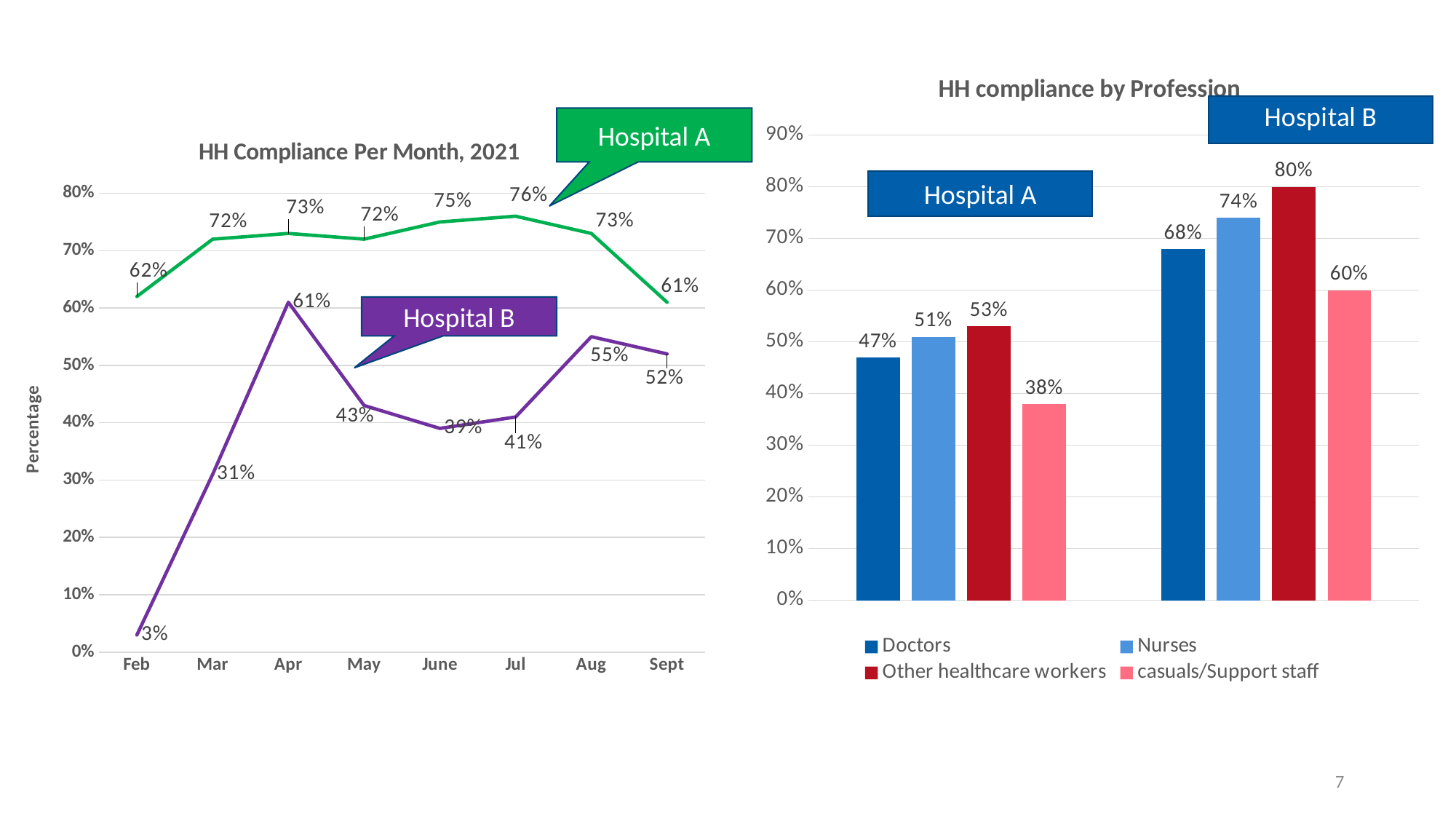
In the 'HH compliance by Profession' chart, how many series does the legend list? 4 In the 'HH Compliance Per Month, 2021' chart, what was Hospital B's compliance in Feb? 3% In the 'HH Compliance Per Month, 2021' chart, what was Hospital A's compliance in Jul? 76% In the 'HH Compliance Per Month, 2021' chart, what is the difference between Hospital A and Hospital B in Sept? 9% In the 'HH Compliance Per Month, 2021' chart, in which month was Hospital A's compliance lowest? Sept What kind of chart is 'HH Compliance Per Month, 2021'? Line chart In the 'HH compliance by Profession' chart, which profession has the lowest compliance at Hospital A? casuals/Support staff In the 'HH Compliance Per Month, 2021' chart, in which month was Hospital B's compliance highest? Apr In the 'HH compliance by Profession' chart, what is the compliance for Nurses at Hospital B? 74% In the 'HH compliance by Profession' chart, which profession has the highest compliance at Hospital B? Other healthcare workers In the 'HH compliance by Profession' chart, what is the difference between Doctors at Hospital B and Doctors at Hospital A? 21% In the 'HH Compliance Per Month, 2021' chart, how many months are shown on the x axis? 8